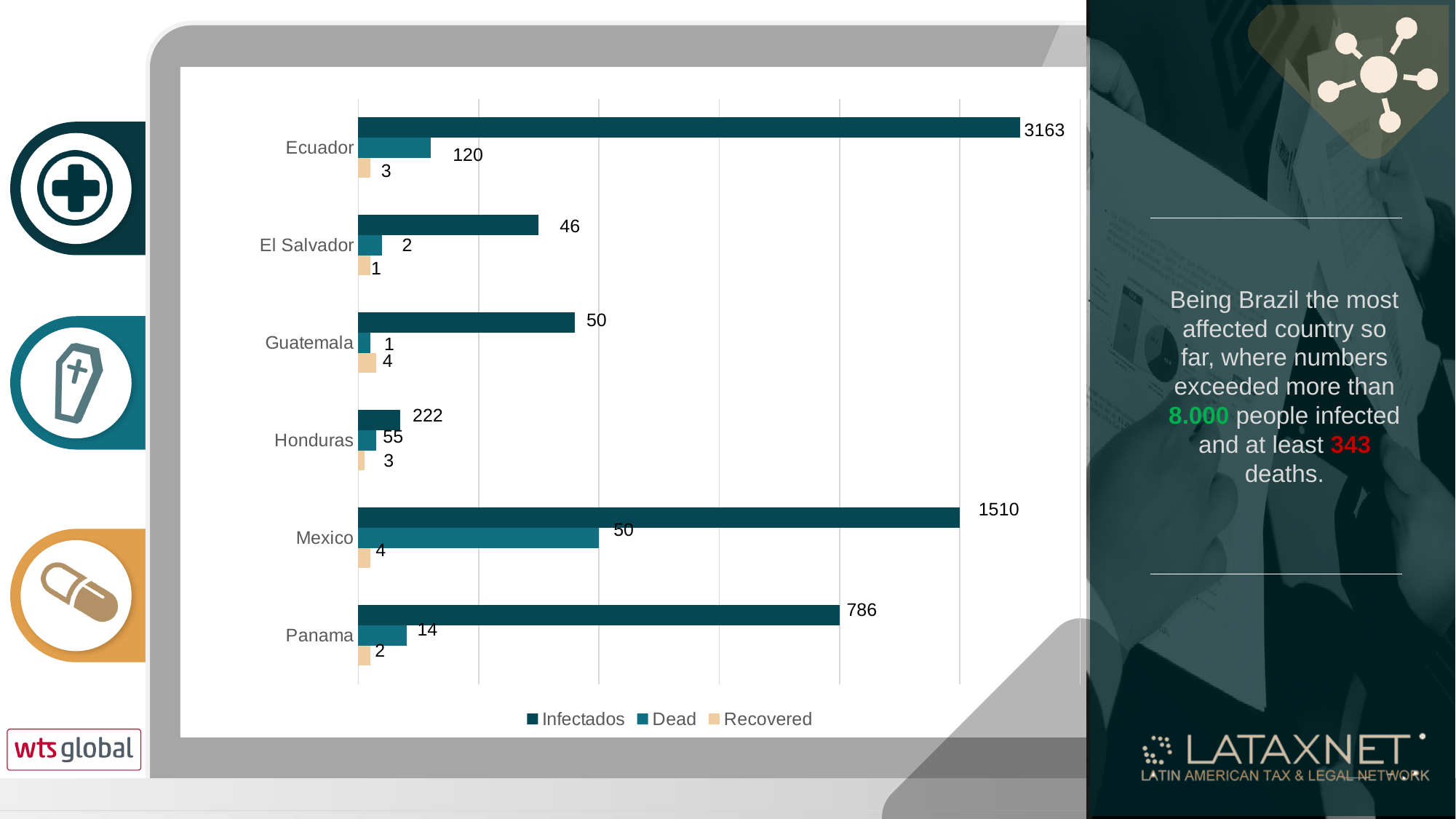
How many series does the chart legend list? 3 What is the Infectados value for Panama? 786 What is the Dead value for Honduras? 55 What is the difference between the Infectados values for Ecuador and Mexico? 1653 Which country has the highest Infectados value? Ecuador What is the Infectados value for Ecuador? 3163 What type of chart is shown on the slide? bar chart What are the three series listed in the chart legend? Infectados, Dead, Recovered How many countries are shown on the chart? 6 Which country has the highest Dead value? Ecuador What is the Recovered value for Guatemala? 4 Which is larger, the Dead value for Mexico or the Dead value for Panama? Mexico